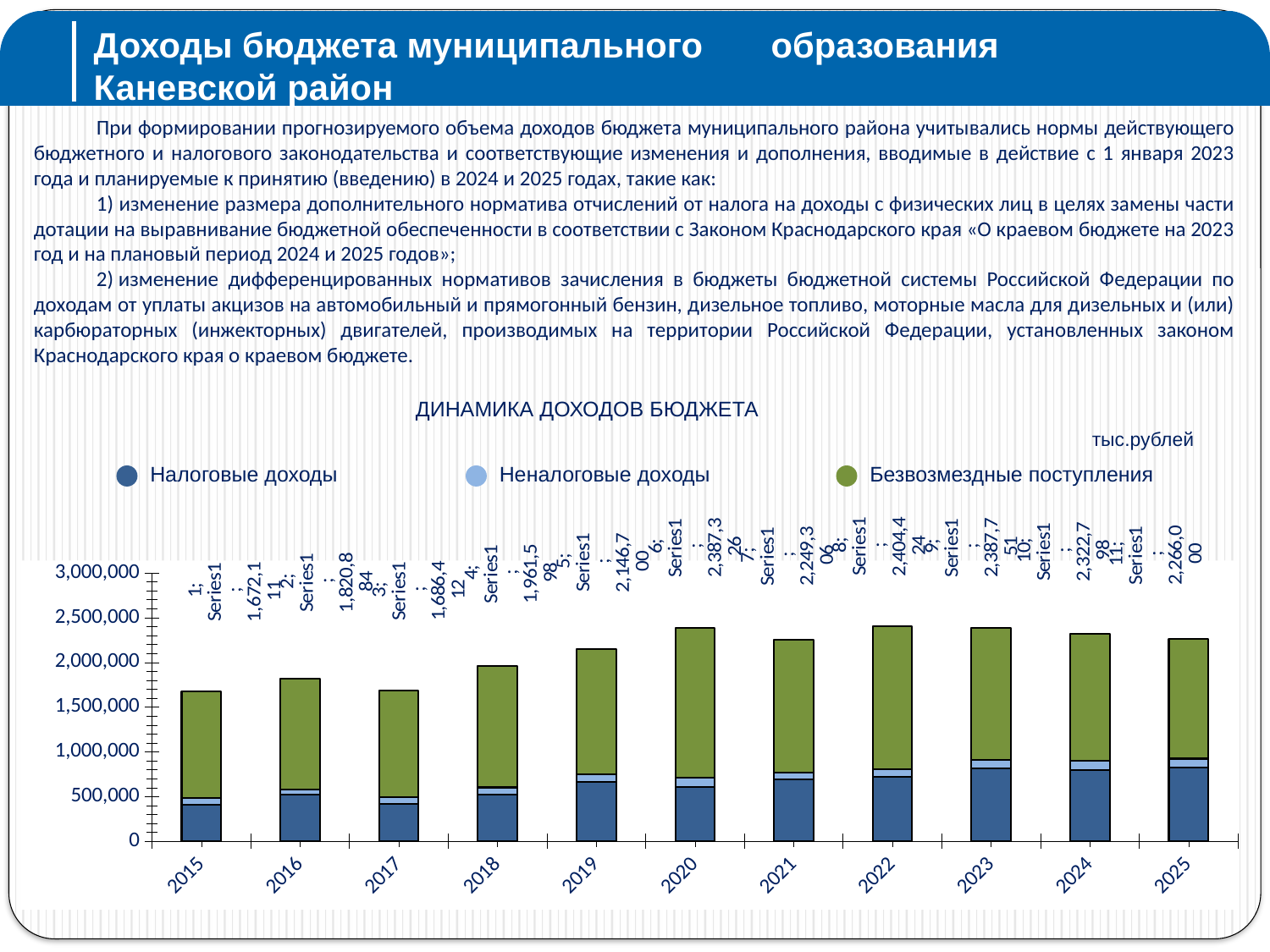
Which series is shown in green in the ДИНАМИКА ДОХОДОВ БЮДЖЕТА chart? Безвозмездные поступления In the ДИНАМИКА ДОХОДОВ БЮДЖЕТА chart, do the total bars generally rise or fall from 2017 to 2020? rise What total value is labelled for 2025 in the ДИНАМИКА ДОХОДОВ БЮДЖЕТА chart? 2,266,000 What unit is indicated for the values in the ДИНАМИКА ДОХОДОВ БЮДЖЕТА chart? тыс.рублей In the ДИНАМИКА ДОХОДОВ БЮДЖЕТА chart, which year has the larger total bar, 2016 or 2019? 2019 In the ДИНАМИКА ДОХОДОВ БЮДЖЕТА chart, which year has the larger total bar, 2015 or 2022? 2022 Is the total bar for 2015 in the ДИНАМИКА ДОХОДОВ БЮДЖЕТА chart greater or less than 2,000,000? less How many years are shown on the x axis of the ДИНАМИКА ДОХОДОВ БЮДЖЕТА chart? 11 How many series does the legend of the ДИНАМИКА ДОХОДОВ БЮДЖЕТА chart list? 3 Is the total bar for 2020 in the ДИНАМИКА ДОХОДОВ БЮДЖЕТА chart greater or less than 2,000,000? greater What kind of chart is shown under the heading ДИНАМИКА ДОХОДОВ БЮДЖЕТА? Stacked bar chart